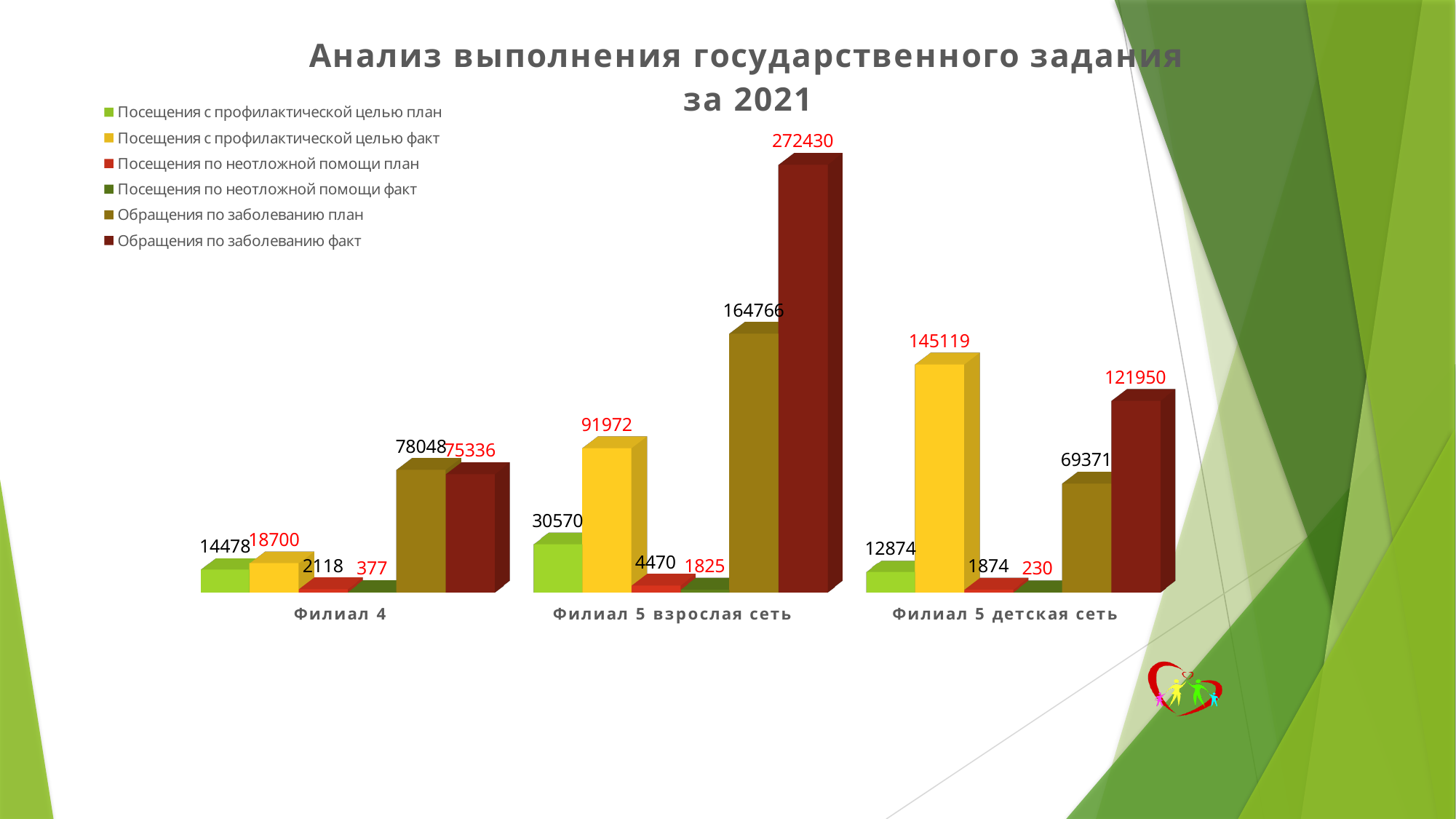
How many categories are shown on the x axis? 3 Which category has the lowest value for 'Посещения по неотложной помощи факт'? Филиал 5 детская сеть Which category has the highest value for 'Обращения по заболеванию факт'? Филиал 5 взрослая сеть What is the value of 'Посещения по неотложной помощи план' for Филиал 4? 2118 How many series does the legend list? 6 What kind of chart is shown on the slide? Bar chart What is the value of 'Обращения по заболеванию факт' for Филиал 5 взрослая сеть? 272430 What is the difference between 'Посещения с профилактической целью факт' and 'Посещения с профилактической целью план' for Филиал 4? 4222 What is the title of the chart? Анализ выполнения государственного задания за 2021 What is the value of 'Посещения с профилактической целью факт' for Филиал 5 детская сеть? 145119 For Филиал 5 взрослая сеть, which is larger: 'Обращения по заболеванию план' or 'Обращения по заболеванию факт'? Обращения по заболеванию факт What is the value of 'Обращения по заболеванию план' for Филиал 5 детская сеть? 69371